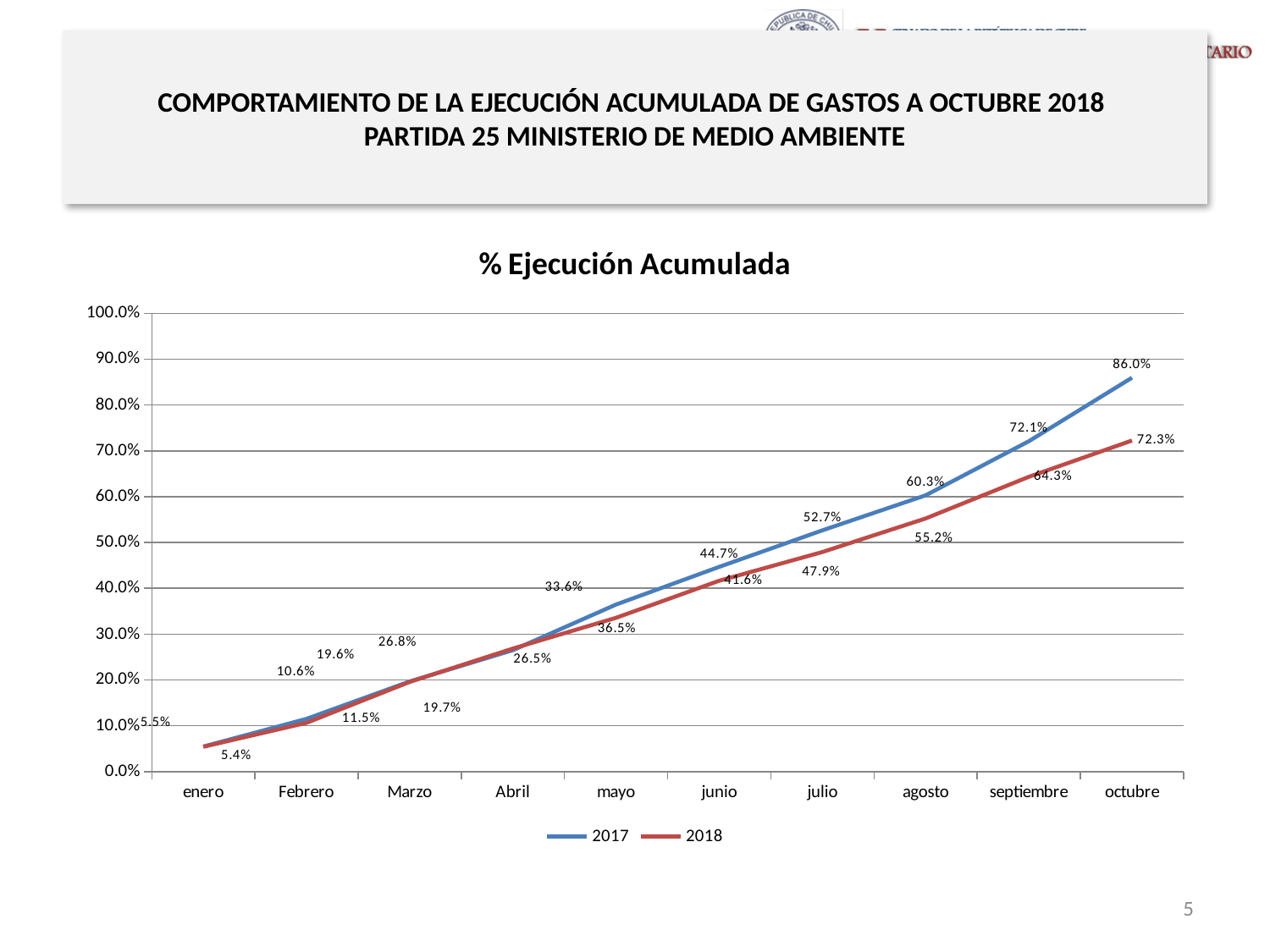
What type of chart is shown on the slide? line chart What is the value for 2018 in octubre? 72.3% What is the value for 2017 in septiembre? 72.1% What is the value for 2017 in julio? 52.7% How many months are plotted along the x axis? 10 Do the values for 2018 rise or fall from enero to octubre? rise What is the value for 2018 in agosto? 55.2% How many series does the legend list? 2 What is the title of the chart? % Ejecución Acumulada What is the value for 2017 in octubre? 86.0% What is the difference between the 2017 and 2018 values in octubre? 13.7% Which series has the higher value in septiembre, 2017 or 2018? 2017